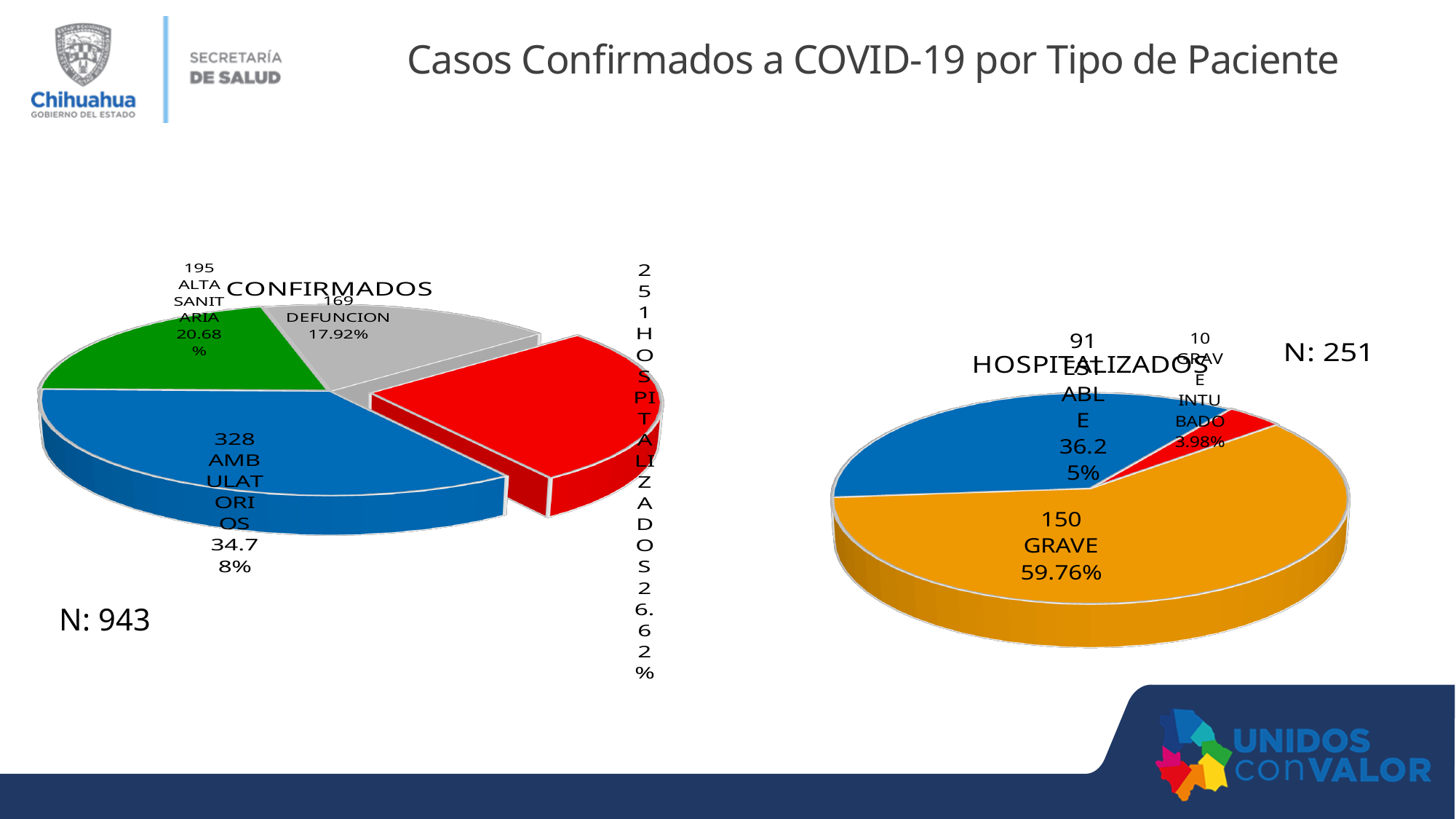
How many categories does the HOSPITALIZADOS chart show? 3 In the HOSPITALIZADOS chart, how many cases are GRAVE? 150 In the CONFIRMADOS chart, which category has the smallest number of cases? DEFUNCION In the HOSPITALIZADOS chart, which is larger, ESTABLE or GRAVE? GRAVE In the CONFIRMADOS chart, what share of the pie is ALTA SANITARIA? 20.68% What type of chart is the HOSPITALIZADOS chart? Pie chart In the CONFIRMADOS chart, what is the difference between the number of AMBULATORIOS cases and ALTA SANITARIA cases? 133 In the HOSPITALIZADOS chart, what percentage of cases are GRAVE INTUBADO? 3.98% In the CONFIRMADOS chart, how many cases are HOSPITALIZADOS? 251 In the CONFIRMADOS chart, what percentage of cases are DEFUNCION? 17.92% In the CONFIRMADOS chart, how many cases are AMBULATORIOS? 328 In the CONFIRMADOS chart, which category has the largest number of cases? AMBULATORIOS